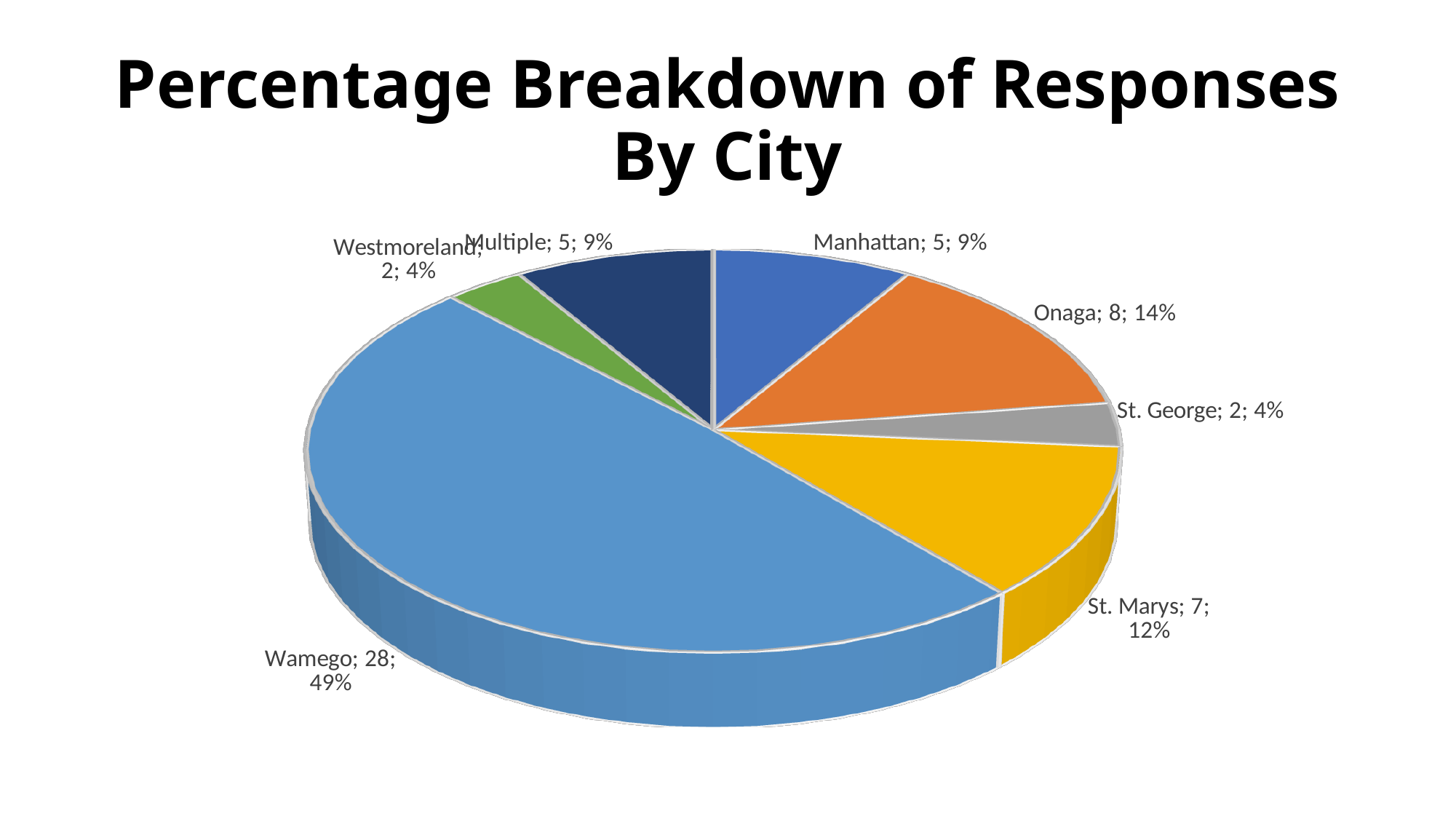
How many slices does the pie chart have? 7 What is the count of responses for St. George? 2 Which has more responses, Onaga or St. Marys? Onaga What share of the pie does Wamego represent? 49% What is the difference in response count between Wamego and Onaga? 20 What is the count of responses for Onaga? 8 What percentage of responses came from St. Marys? 12% What kind of chart is shown on the slide? pie chart Which city has the largest share of responses? Wamego What percentage of responses came from Manhattan? 9% What is the title of the chart? Percentage Breakdown of Responses By City What is the count of responses for Wamego? 28